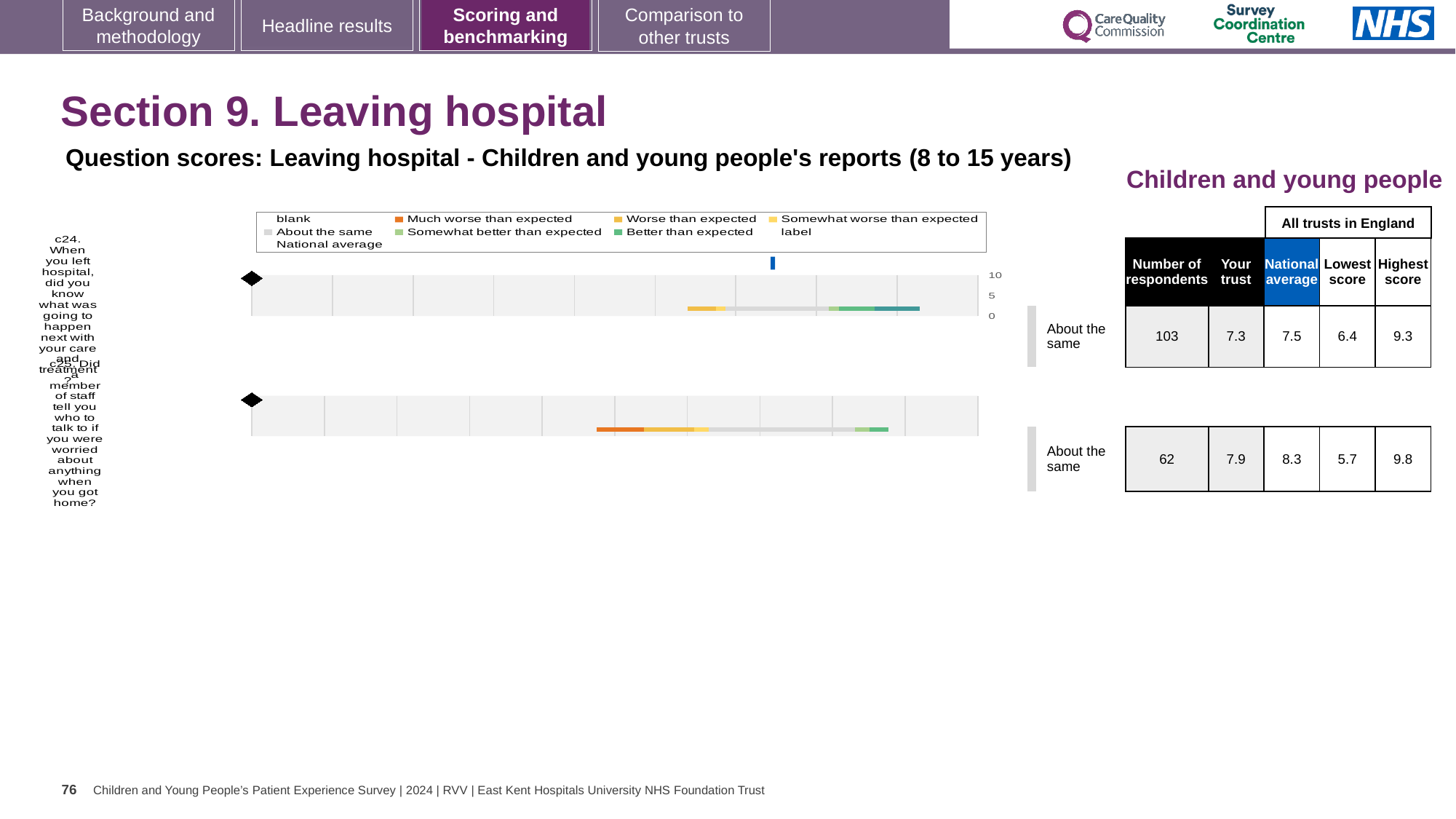
What is the difference between the highest and lowest scores for c25? 4.1 What is the 'Your trust' score for c24 (When you left hospital, did you know what was going to happen next with your care and treatment?)? 7.3 How many questions are plotted on the slide? 2 What is the difference between the national average and the trust score for c24? 0.2 What is the lowest score among all trusts in England for c25? 5.7 What kind of chart is used to show the question scores for c24 and c25? bar chart Which question has the higher 'Your trust' score, c24 or c25? c25 How many respondents answered question c25? 62 What is the national average score for c25 (Did a member of staff tell you who to talk to if you were worried about anything when you got home?)? 8.3 What benchmark category is shown for the trust's score on c24? About the same What is the highest score among all trusts in England for c24? 9.3 How many respondents answered question c24? 103